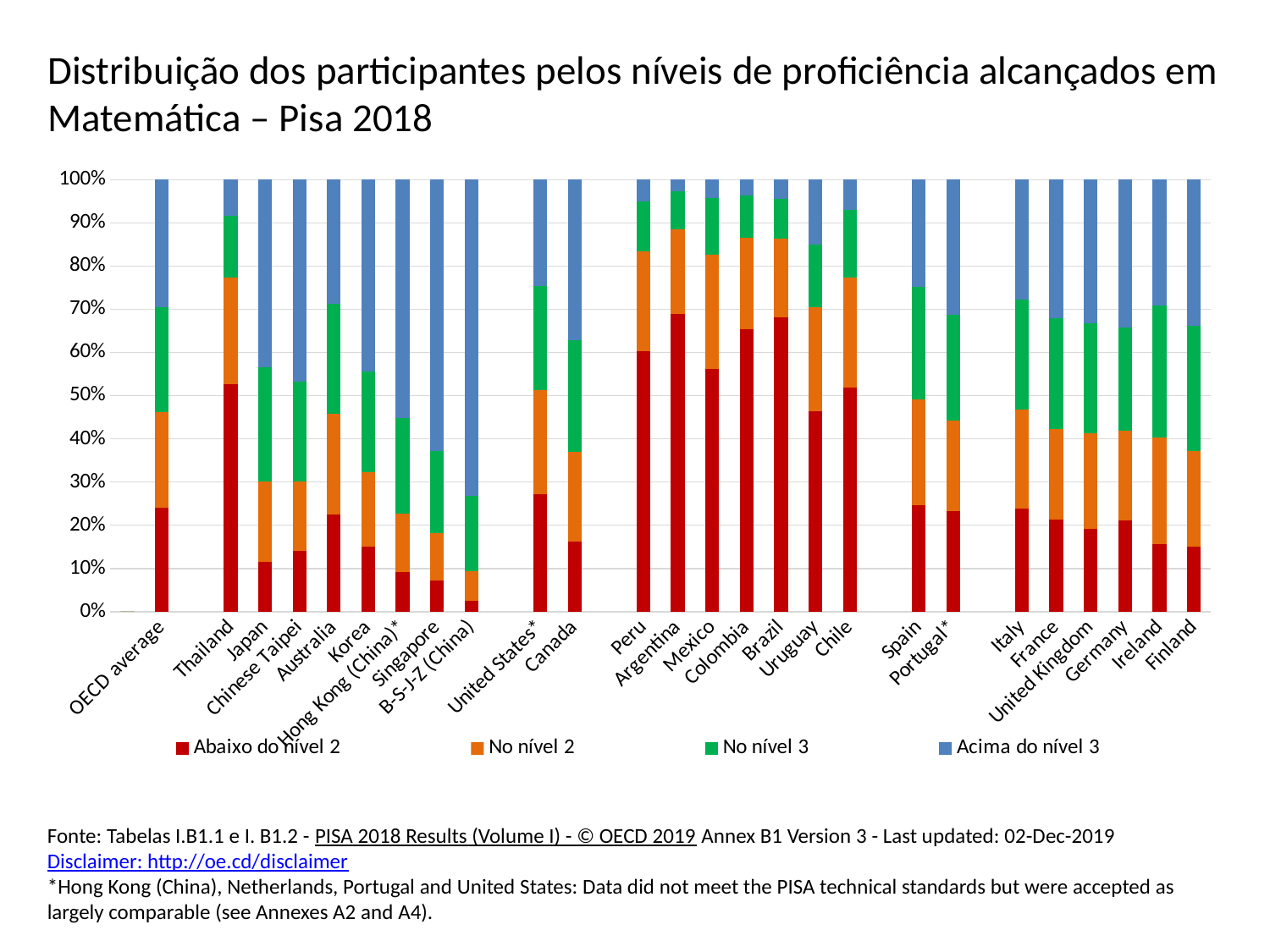
Is the value of 'Abaixo do nível 2' for B-S-J-Z (China) greater or less than 10%? less Is the value of 'Abaixo do nível 2' for Brazil greater or less than 60%? greater Which category has the highest share of 'Acima do nível 3'? B-S-J-Z (China) How many countries/categories are plotted along the x axis? 26 Which colour represents 'Acima do nível 3' in the legend? Blue Which has a larger share of 'Abaixo do nível 2', Thailand or Japan? Thailand Which category has the lowest share of 'Abaixo do nível 2'? B-S-J-Z (China) Which has a larger share of 'Acima do nível 3', Singapore or Canada? Singapore Is the value of 'Abaixo do nível 2' for Argentina greater or less than 60%? greater What kind of chart is shown on the slide? Stacked bar chart How many series does the legend list? 4